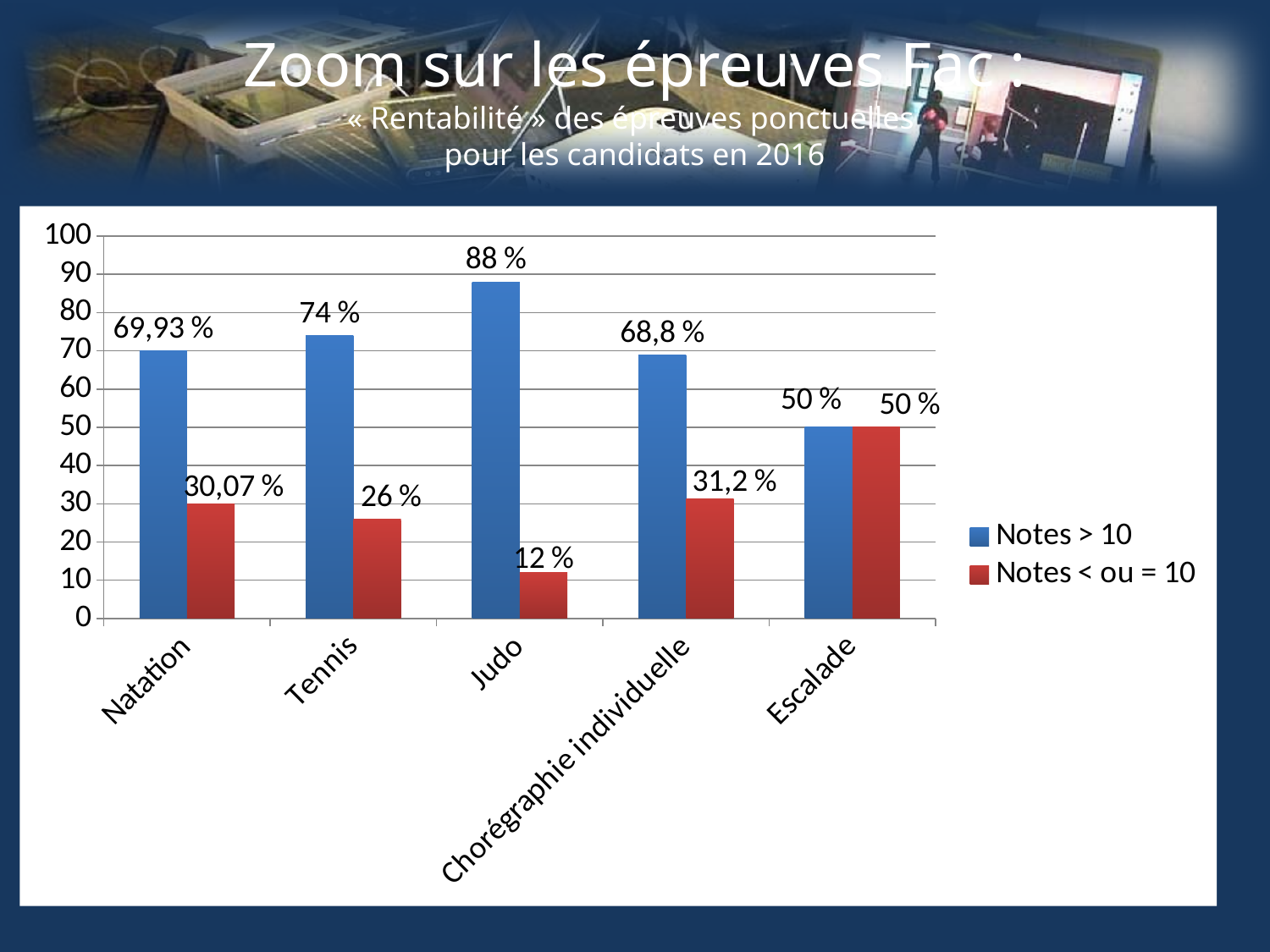
Which category has the highest value for "Notes > 10"? Judo What colour are the bars for the "Notes < ou = 10" series? red Which category has the lowest value for "Notes < ou = 10"? Judo What is the value of "Notes < ou = 10" for Natation? 30,07 % How many categories are shown on the x axis? 5 How many series does the legend list? 2 Is the value of "Notes > 10" for Escalade greater or less than 60? less What is the difference between the "Notes > 10" values for Tennis and Natation? 4,07 % What is the value of "Notes > 10" for Chorégraphie individuelle? 68,8 % Which is larger: "Notes < ou = 10" for Tennis or for Chorégraphie individuelle? Chorégraphie individuelle What kind of chart is shown on the slide? bar chart What is the value of "Notes > 10" for Judo? 88 %